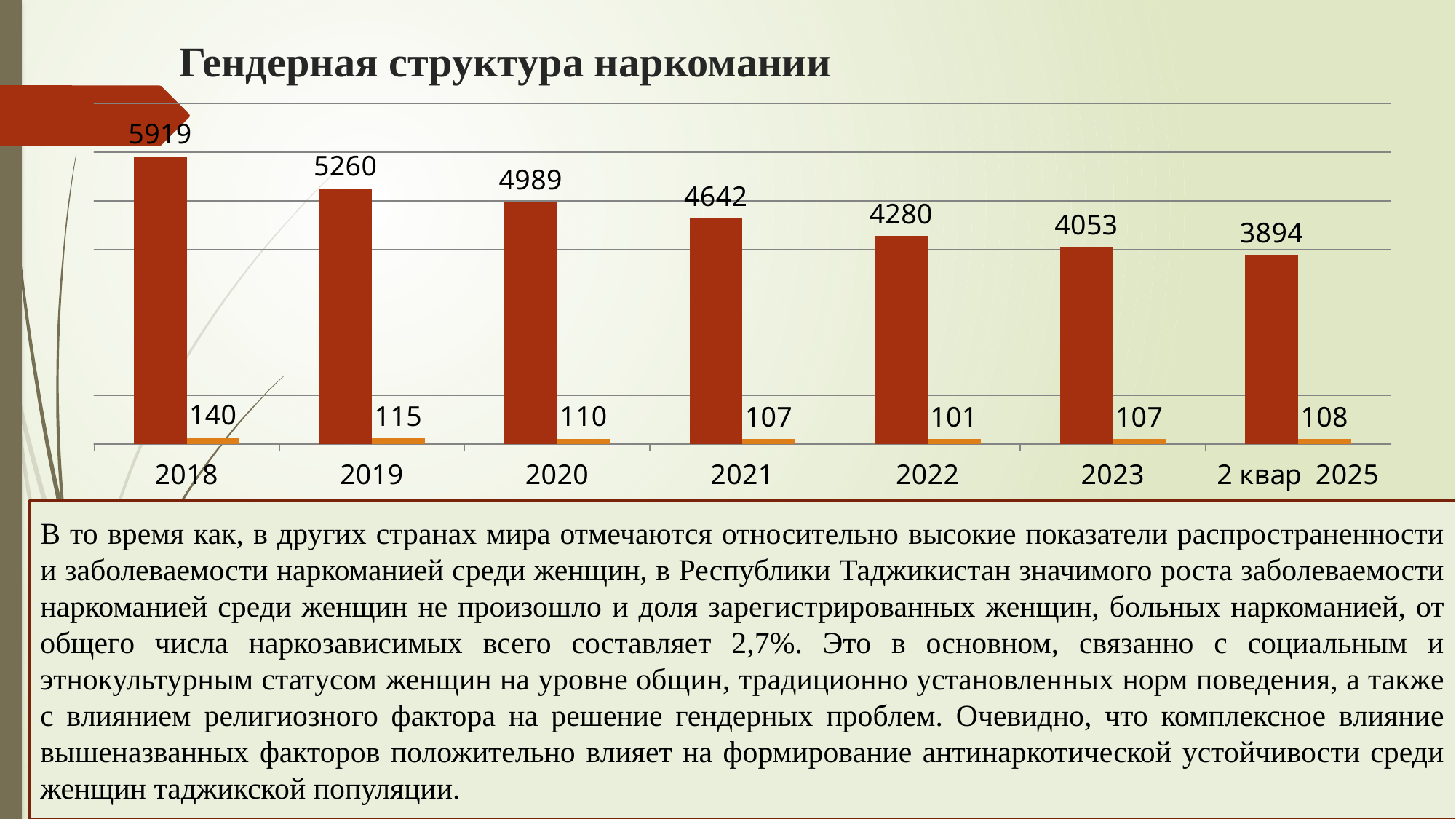
What is the value of the orange bar for 2022? 101 What is the value of the red bar for 2 квар 2025? 3894 What is the value of the red bar for 2018? 5919 What kind of chart is shown on the slide? Bar chart What is the difference between the red bar values for 2018 and 2019? 659 What is the value of the orange bar for 2019? 115 Do the red bar values rise or fall from 2018 to 2 квар 2025? Fall What is the difference between the orange bar values for 2018 and 2 квар 2025? 32 Which is larger, the red bar for 2021 or the red bar for 2023? 2021 How many categories are shown on the x axis? 7 Which category has the lowest orange bar? 2022 Which category has the highest red bar? 2018